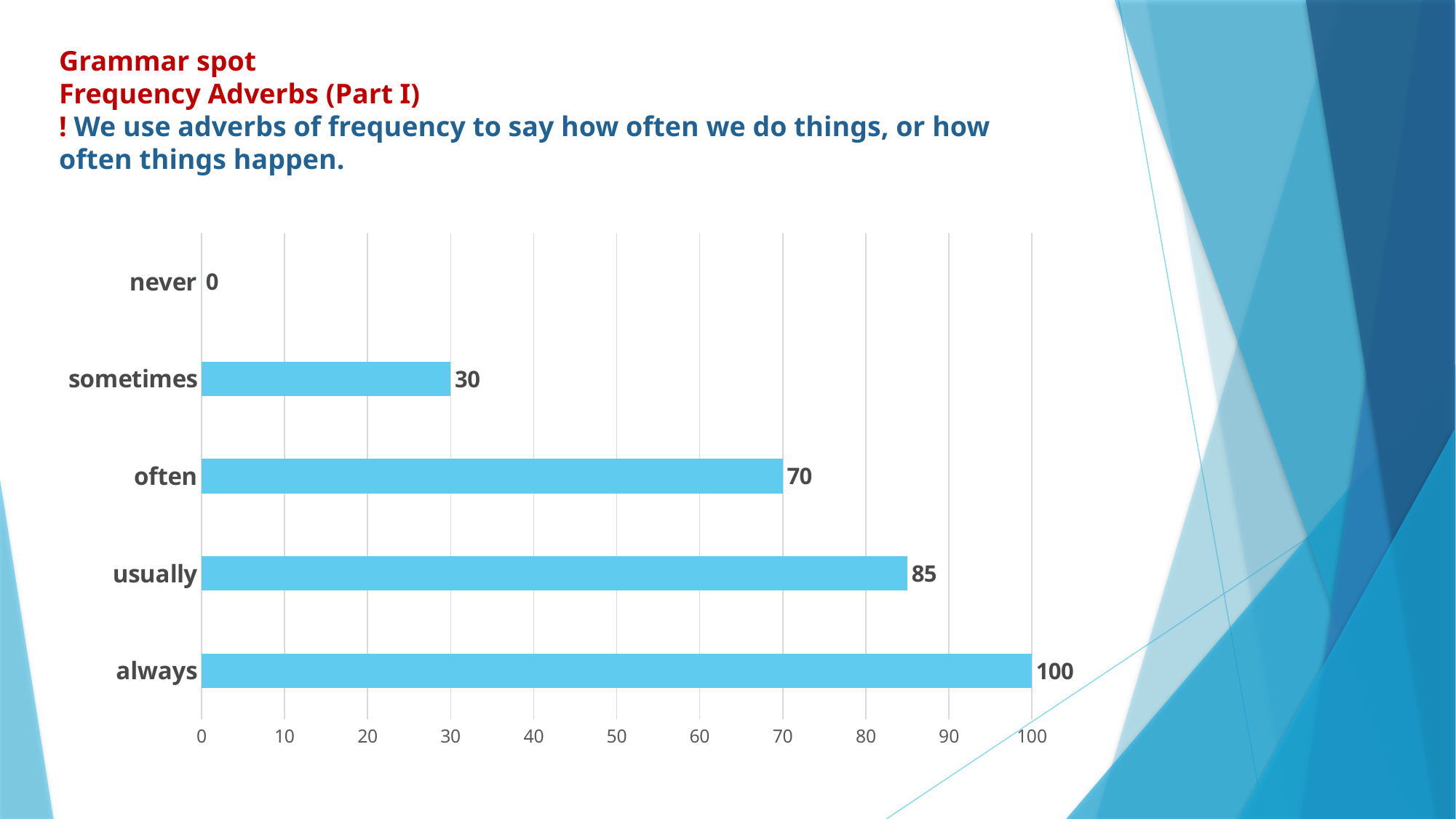
What is the value for "never"? 0 How many categories are shown in the chart? 5 Which category has the highest value? always What is the value for "usually"? 85 What is the highest value shown on the horizontal axis? 100 What kind of chart is shown on the slide? bar chart What is the difference between the values for "often" and "sometimes"? 40 What is the difference between the values for "always" and "usually"? 15 Which is larger, the value for "often" or the value for "usually"? usually Which category has the lowest value? never What is the value for "often"? 70 What is the value for "sometimes"? 30